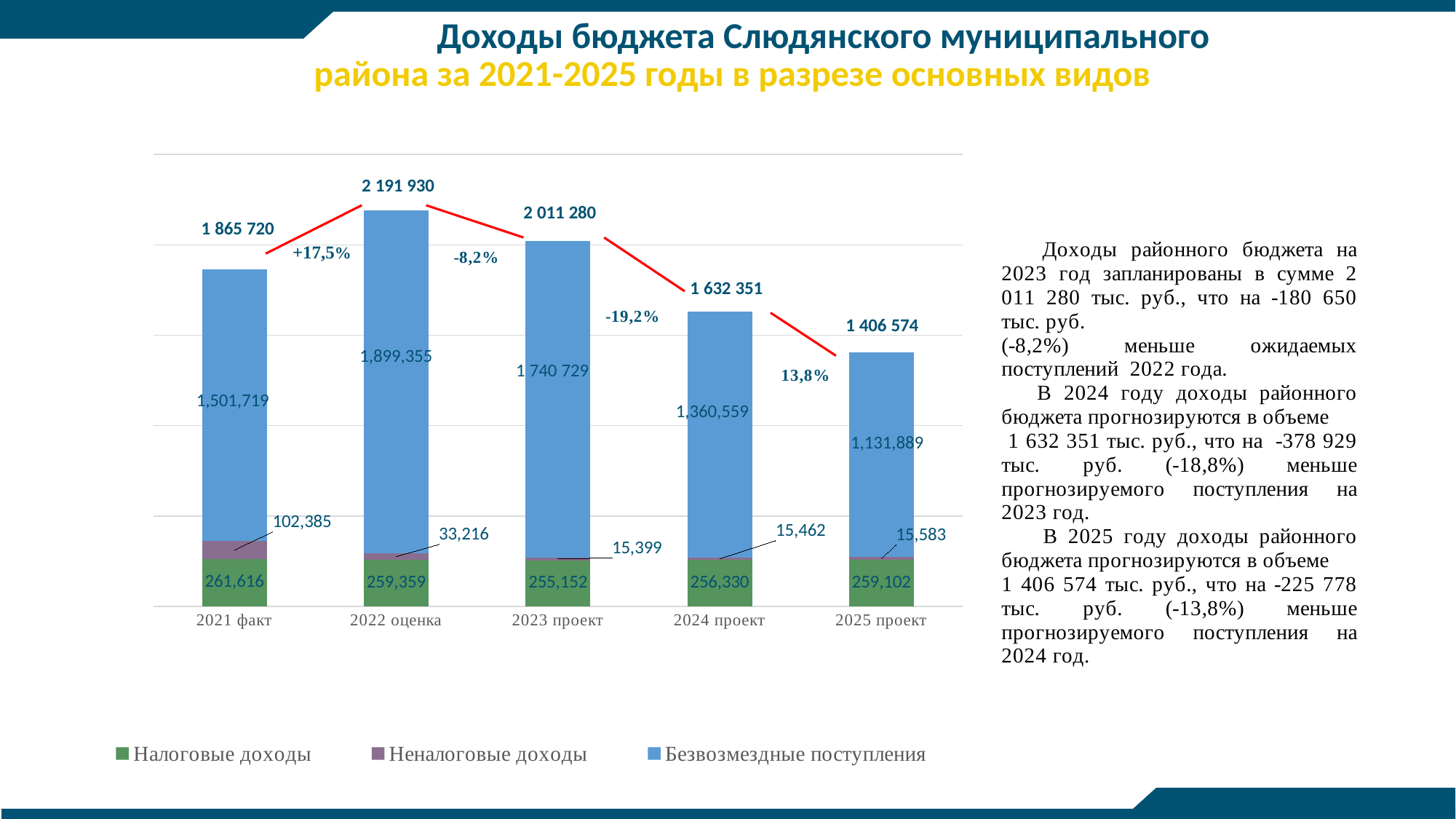
What is the total labelled above the bar for 2025 проект? 1 406 574 What is the value of Налоговые доходы for 2023 проект? 255,152 What is the difference between the Неналоговые доходы values for 2021 факт and 2022 оценка? 69,169 How many series does the legend list? 3 Do the total bar values rise or fall from 2022 оценка to 2025 проект? Fall Which year has the lowest value of Безвозмездные поступления? 2025 проект What is the value of Безвозмездные поступления for 2022 оценка? 1,899,355 What kind of chart is shown? Stacked bar chart What is the value of Неналоговые доходы for 2021 факт? 102,385 Which year has the highest total bar? 2022 оценка Which is larger: Налоговые доходы for 2021 факт or for 2024 проект? 2021 факт How many years (categories) are shown on the x axis? 5